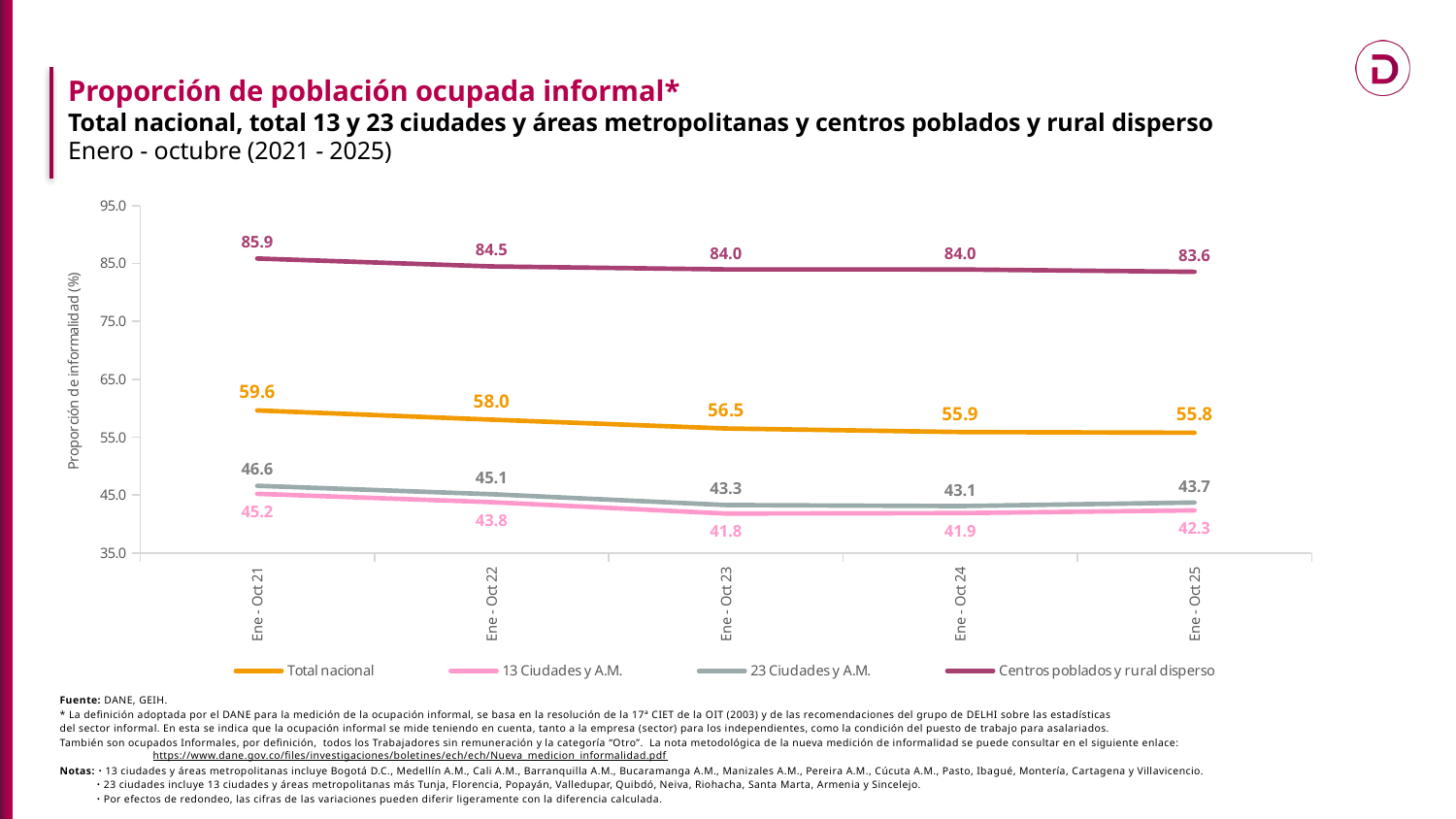
Which is larger in Ene - Oct 24: the value for 23 Ciudades y A.M. or the value for 13 Ciudades y A.M.? 23 Ciudades y A.M. In which period is the value for 23 Ciudades y A.M. highest? Ene - Oct 21 What type of chart is shown on the slide? Line chart Does the Total nacional series rise or fall from Ene - Oct 21 to Ene - Oct 25? Fall What is the value for 13 Ciudades y A.M. in Ene - Oct 23? 41.8 How many periods are plotted along the x axis? 5 In which period is the value for Total nacional lowest? Ene - Oct 25 What is the value for Total nacional in Ene - Oct 21? 59.6 What is the value for Centros poblados y rural disperso in Ene - Oct 25? 83.6 How many series does the legend list? 4 What is the difference between the Centros poblados y rural disperso value in Ene - Oct 21 and in Ene - Oct 25? 2.3 What is the label of the y axis? Proporción de informalidad (%)